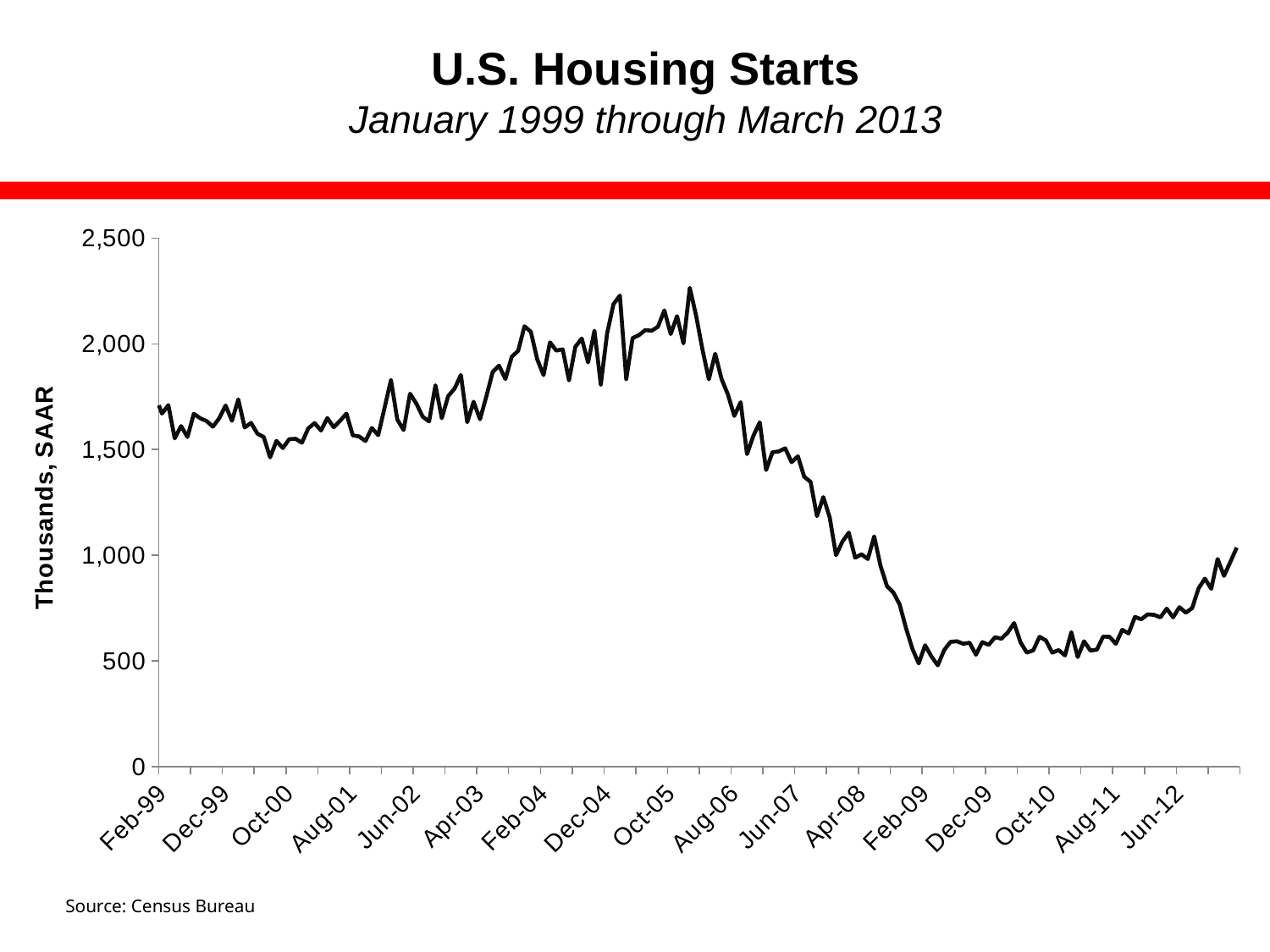
Which is larger, the value for Feb-04 or the value for Feb-09? Feb-04 Is the value for Feb-99 greater or less than 1,500? greater Does the series rise or fall between Oct-05 and Feb-09? Fall Is the value for Jun-12 greater or less than 1,000? less What is the title of the chart? U.S. Housing Starts What is the label on the vertical axis of the chart? Thousands, SAAR Is the value for Oct-05 greater or less than 1,500? greater What kind of chart is shown on the slide? Line chart How many date labels are shown along the x axis? 17 Does the series rise or fall between Dec-09 and the end of the chart? Rise